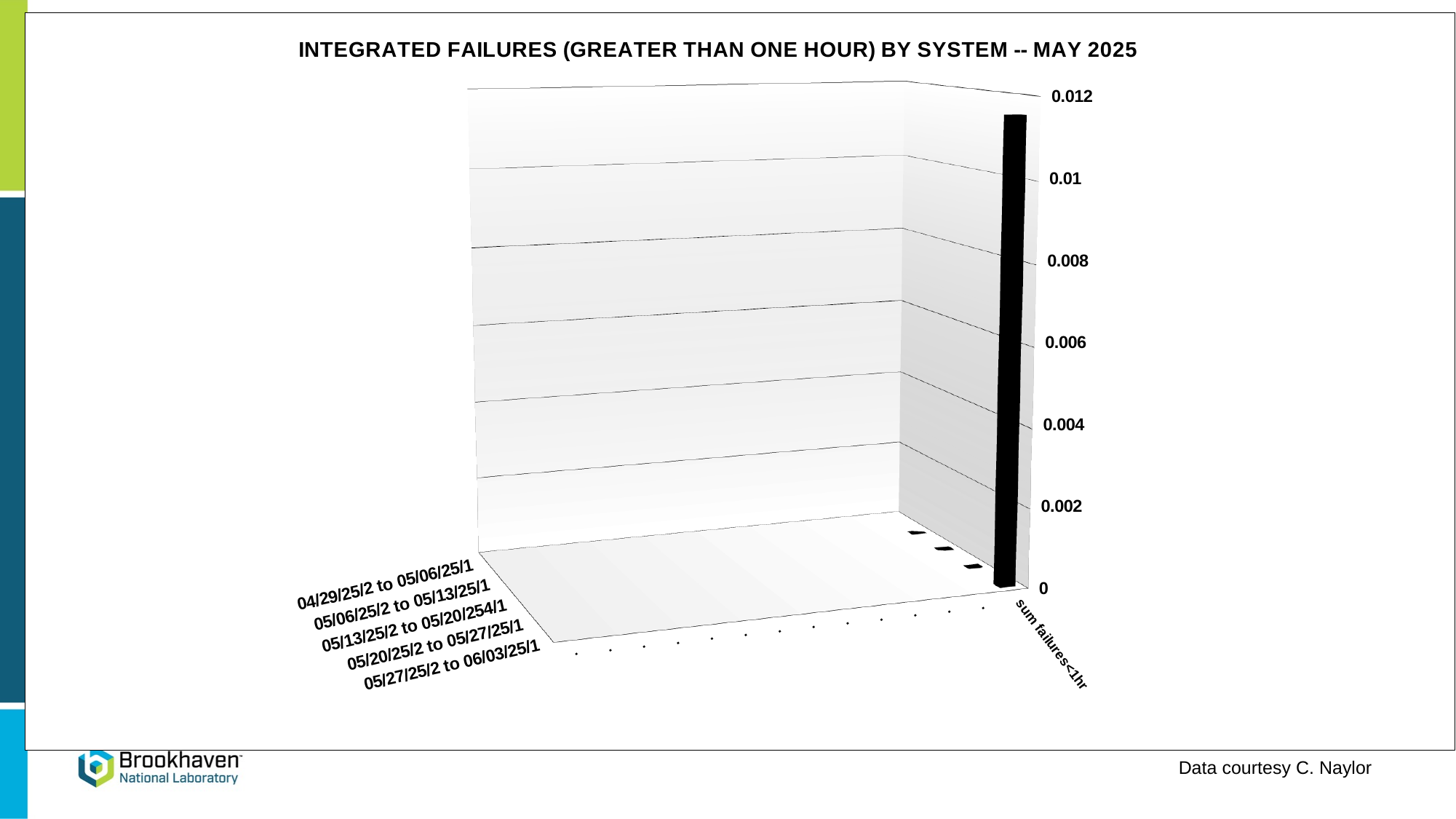
What is the title of the chart? INTEGRATED FAILURES (GREATER THAN ONE HOUR) BY SYSTEM -- MAY 2025 What kind of chart is shown on the slide? bar chart What is the readable label at the far right end of the depth axis of the chart? sum failures<1hr Is the value of the tallest bar in the chart greater or less than 0.012? less Is the value of the tallest bar in the chart greater or less than 0.01? greater How many date-range categories are labelled along the x axis of the chart? 5